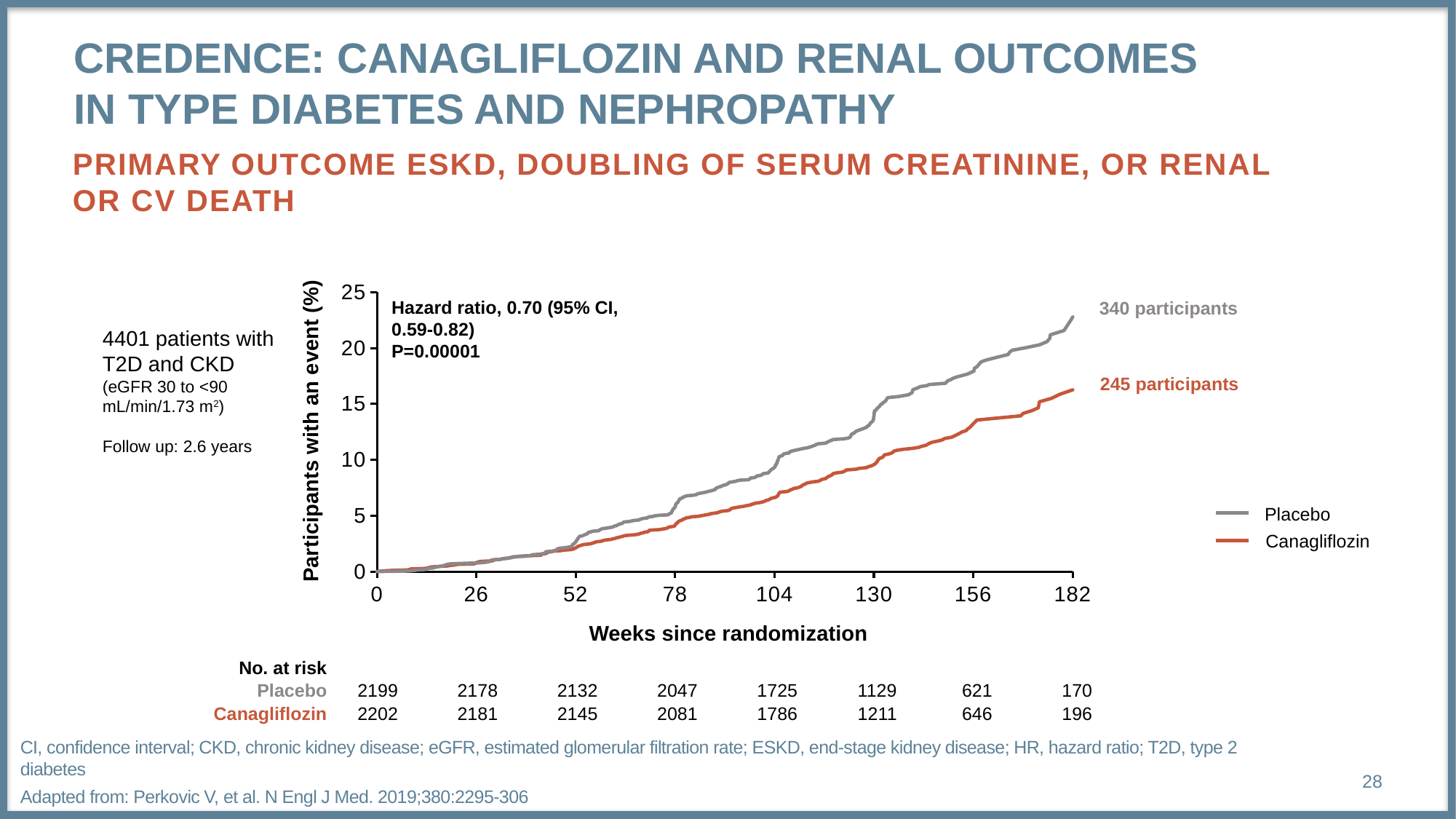
At 182 weeks, is the percentage of participants with an event in the Placebo group greater or less than 20? greater Which group had more participants with an event, Placebo or Canagliflozin? Placebo How many participants had an event in the Canagliflozin group? 245 participants What is the number at risk for Canagliflozin at week 182? 196 Do the curves rise or fall as weeks since randomization increase? Rise What is the number at risk for Placebo at week 104? 1725 How many series does the legend list? 2 What kind of chart is shown on the slide? Line chart What hazard ratio is reported on the chart? 0.70 How many participants had an event in the Placebo group? 340 participants At 182 weeks, is the percentage of participants with an event in the Canagliflozin group greater or less than 20? less What is the difference in the number of participants with an event between the Placebo and Canagliflozin groups? 95